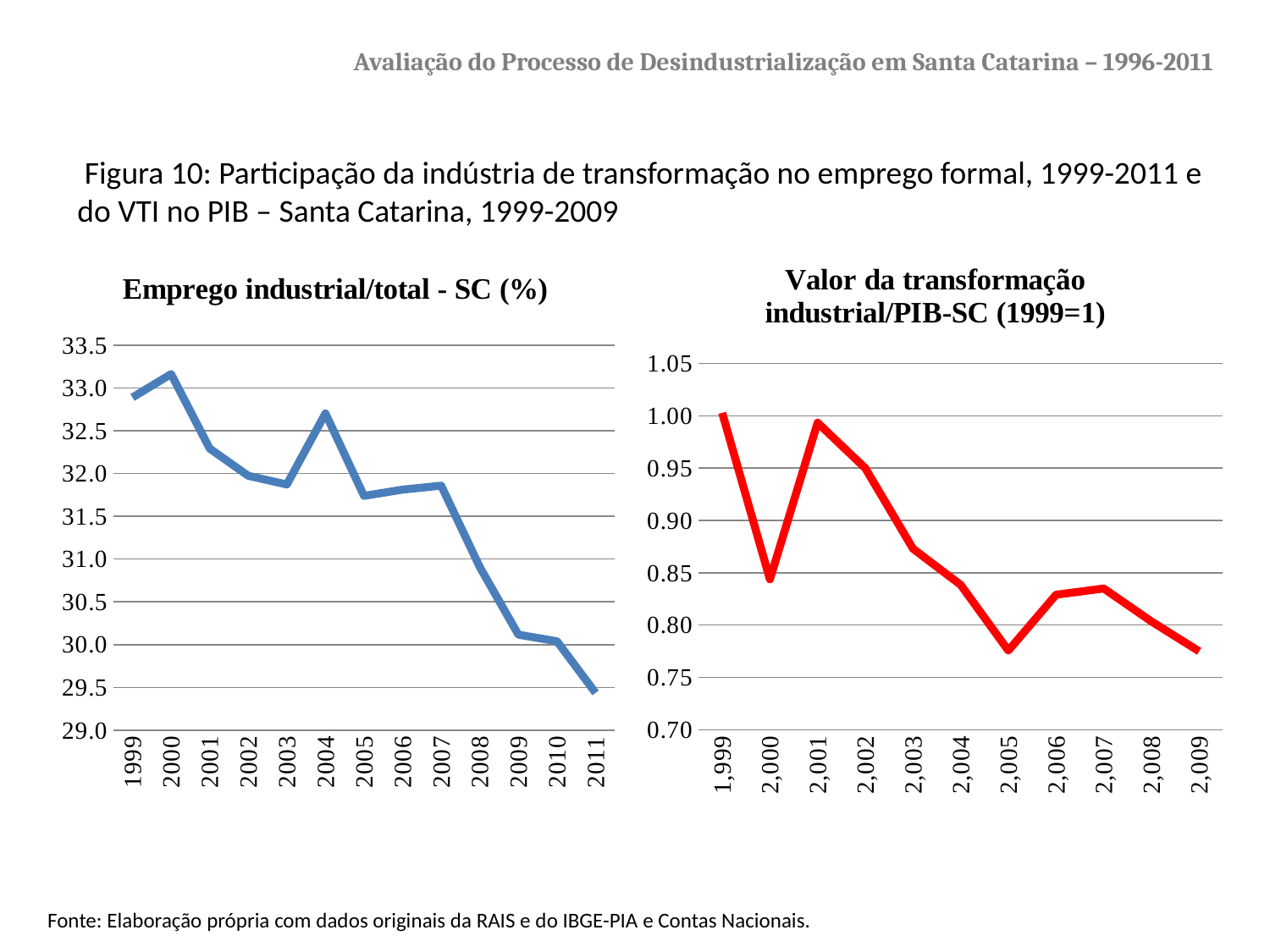
In the right chart "Valor da transformação industrial/PIB-SC (1999=1)", is the value for 2001 greater or less than 0.95? greater In the left chart "Emprego industrial/total - SC (%)", which is larger, the value for 2004 or the value for 2007? 2004 In the left chart "Emprego industrial/total - SC (%)", is the value for 2011 greater or less than 30.0? less In the right chart "Valor da transformação industrial/PIB-SC (1999=1)", is the value for 2005 greater or less than 0.80? less In the right chart "Valor da transformação industrial/PIB-SC (1999=1)", do the values overall rise or fall from 1999 to 2009? fall In the left chart "Emprego industrial/total - SC (%)", which year has the highest value? 2000 In the right chart "Valor da transformação industrial/PIB-SC (1999=1)", how many years are plotted on the x axis? 11 In the left chart "Emprego industrial/total - SC (%)", which year has the lowest value? 2011 In the left chart "Emprego industrial/total - SC (%)", how many years are plotted on the x axis? 13 In the right chart "Valor da transformação industrial/PIB-SC (1999=1)", which is larger, the value for 2006 or the value for 2008? 2006 What kind of chart is the left chart titled "Emprego industrial/total - SC (%)"? Line chart